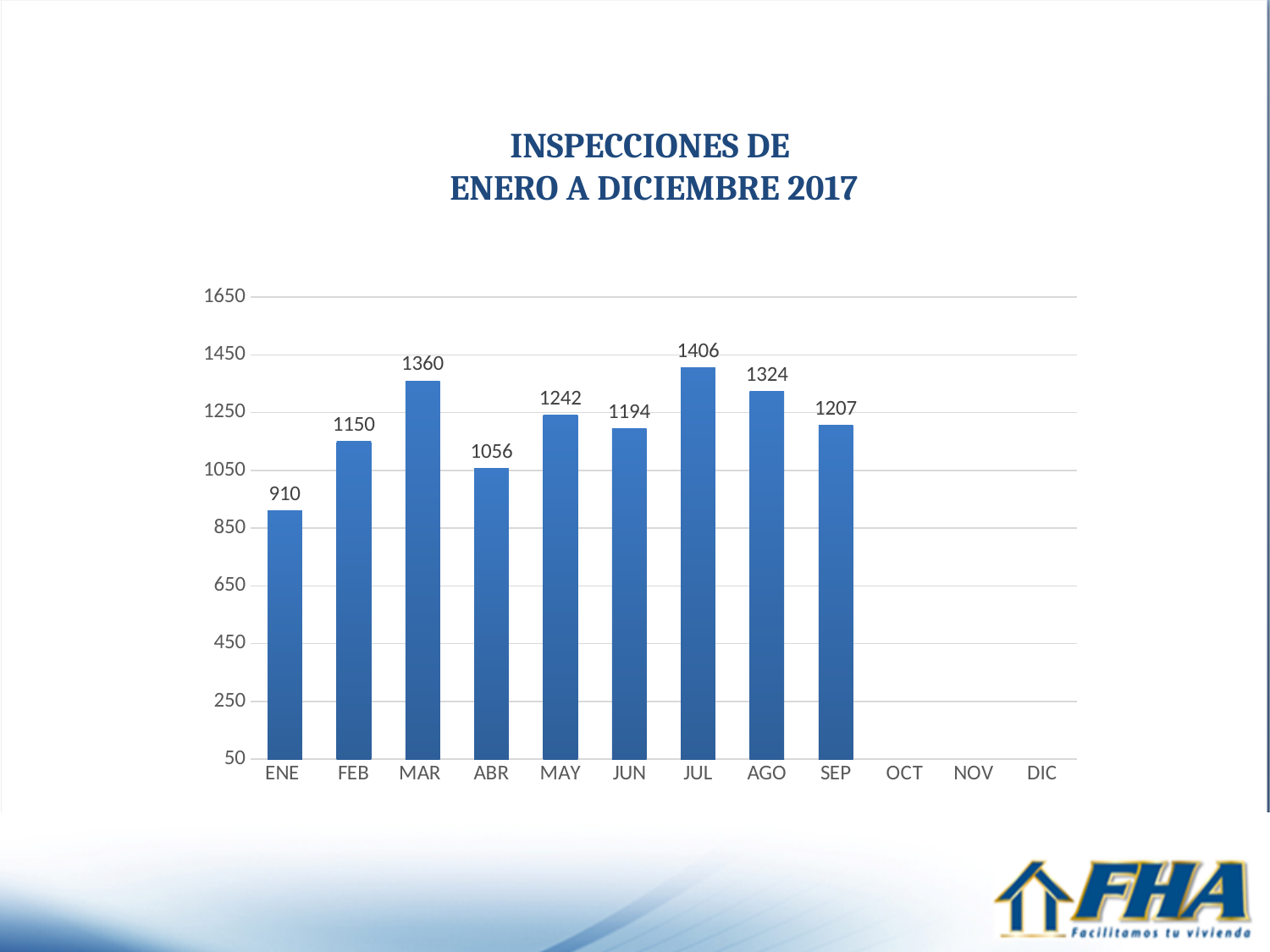
What is the value for ABR? 1056 Which month with a plotted bar has the lowest value? ENE What is the title of the chart? INSPECCIONES DE ENERO A DICIEMBRE 2017 What kind of chart is shown on the slide? bar chart What is the difference between the values for MAY and JUN? 48 How many months have a bar plotted on the chart? 9 How many month categories are shown on the x axis? 12 What is the value for MAR? 1360 Which is larger, the value for AGO or the value for SEP? AGO Which month has the highest value? JUL What is the value for SEP? 1207 What is the difference between the values for JUL and ENE? 496